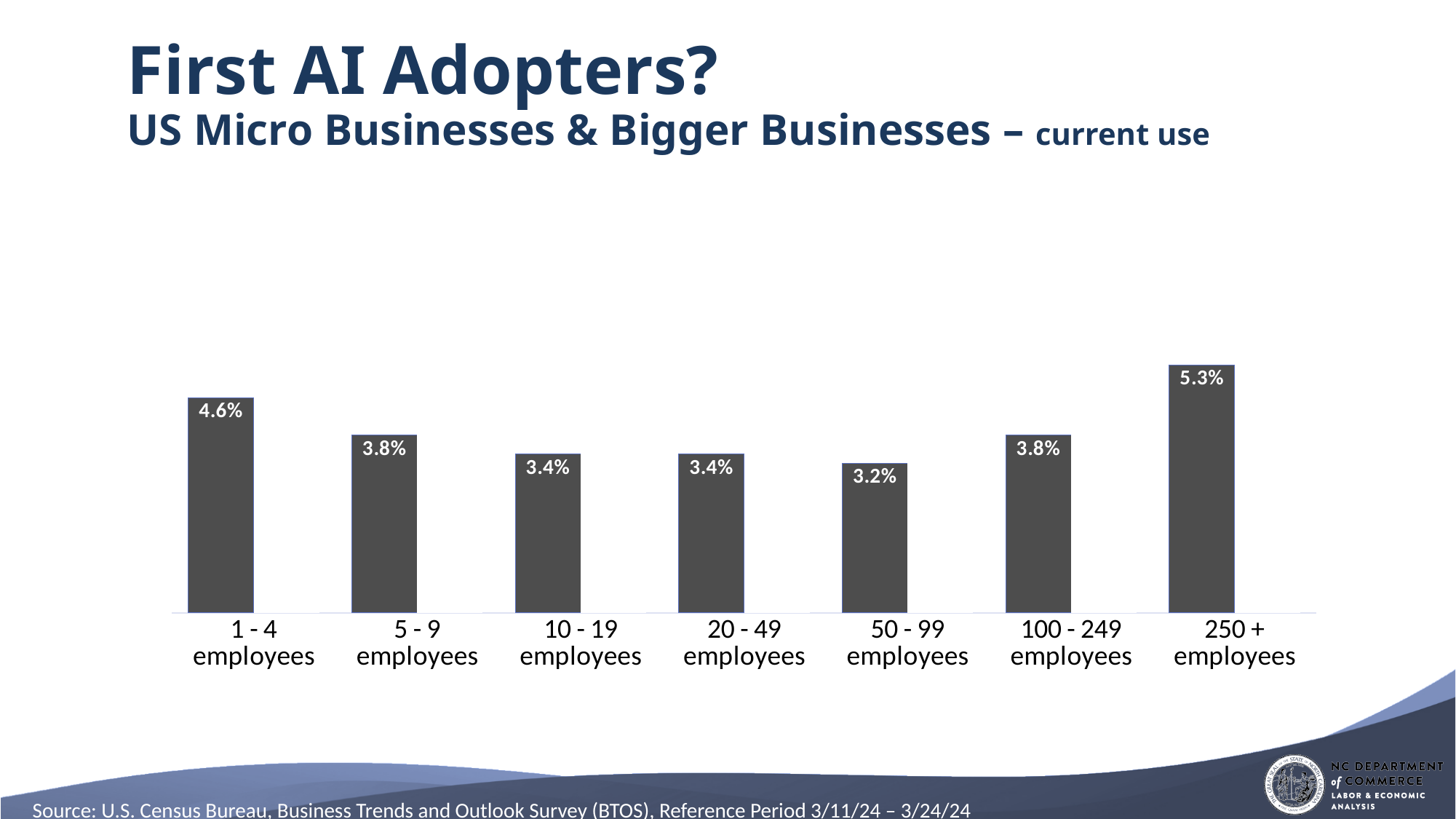
Which employee size category has the lowest value? 50 - 99 employees What is the value for 50 - 99 employees? 3.2% What is the value for 250 + employees? 5.3% What kind of chart is shown on the slide? Bar chart How many employee size categories are shown in the chart? 7 What is the value for 1 - 4 employees? 4.6% Which is larger, the value for 5 - 9 employees or the value for 10 - 19 employees? 5 - 9 employees What is the difference between the values for 250 + employees and 1 - 4 employees? 0.7% Which employee size category has the highest value? 250 + employees What is the difference between the values for 1 - 4 employees and 50 - 99 employees? 1.4% What is the source cited for the chart data? U.S. Census Bureau, Business Trends and Outlook Survey (BTOS) What is the value for 100 - 249 employees? 3.8%